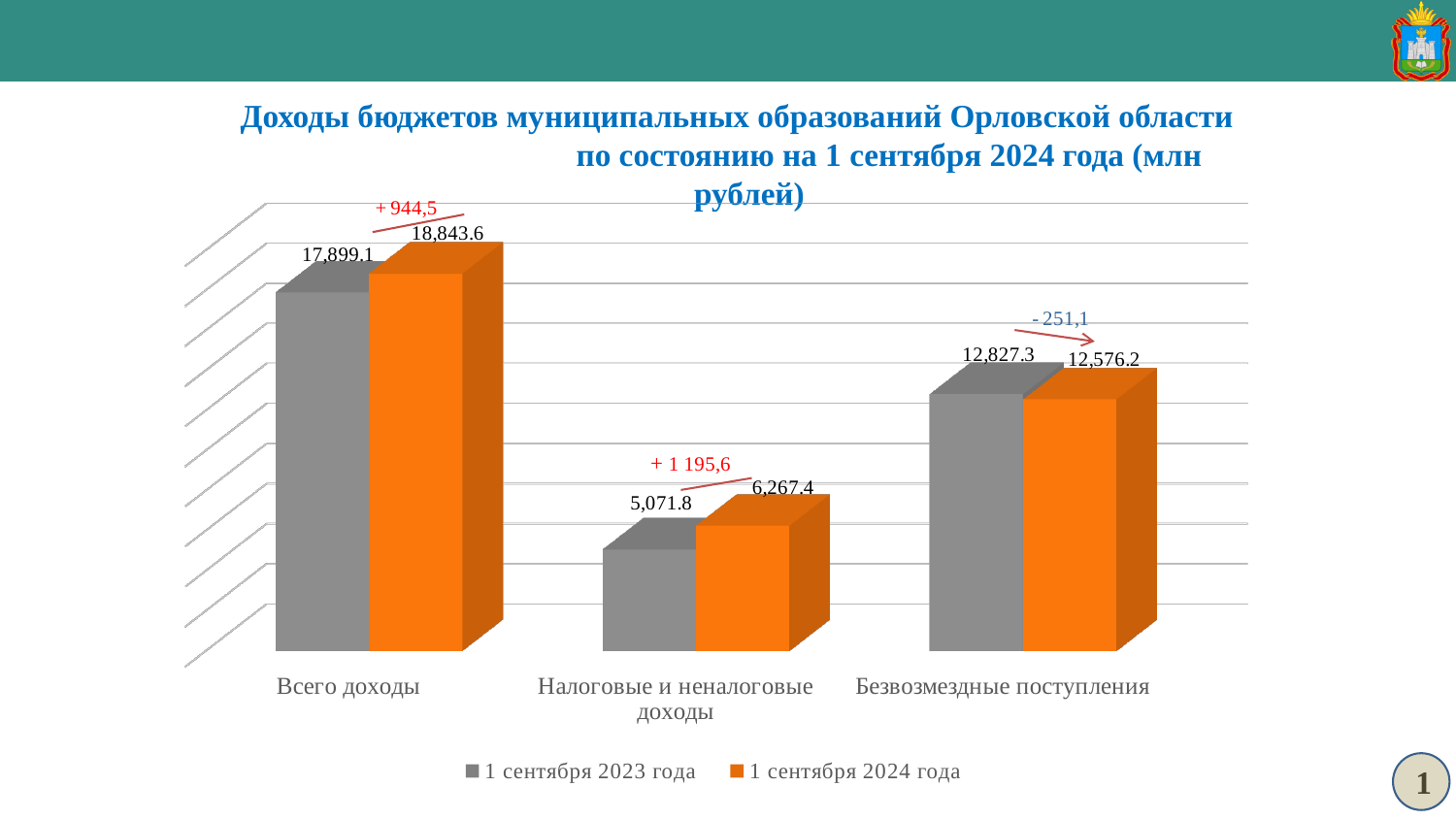
For Безвозмездные поступления, which series has the larger value: 1 сентября 2023 года or 1 сентября 2024 года? 1 сентября 2023 года Which colour represents the 1 сентября 2024 года series? Orange Which category has the lowest value in the 1 сентября 2023 года series? Налоговые и неналоговые доходы What is the difference between the 1 сентября 2023 года and 1 сентября 2024 года values for Безвозмездные поступления? 251.1 How many series does the legend list? 2 What is the value for Безвозмездные поступления in the 1 сентября 2024 года series? 12,576.2 What is the value for Всего доходы in the 1 сентября 2024 года series? 18,843.6 Which category has the highest value in the 1 сентября 2024 года series? Всего доходы What kind of chart is shown on the slide? Bar chart How many categories are shown on the x axis? 3 What is the difference between the 1 сентября 2024 года and 1 сентября 2023 года values for Налоговые и неналоговые доходы? 1,195.6 What is the value for Налоговые и неналоговые доходы in the 1 сентября 2023 года series? 5,071.8